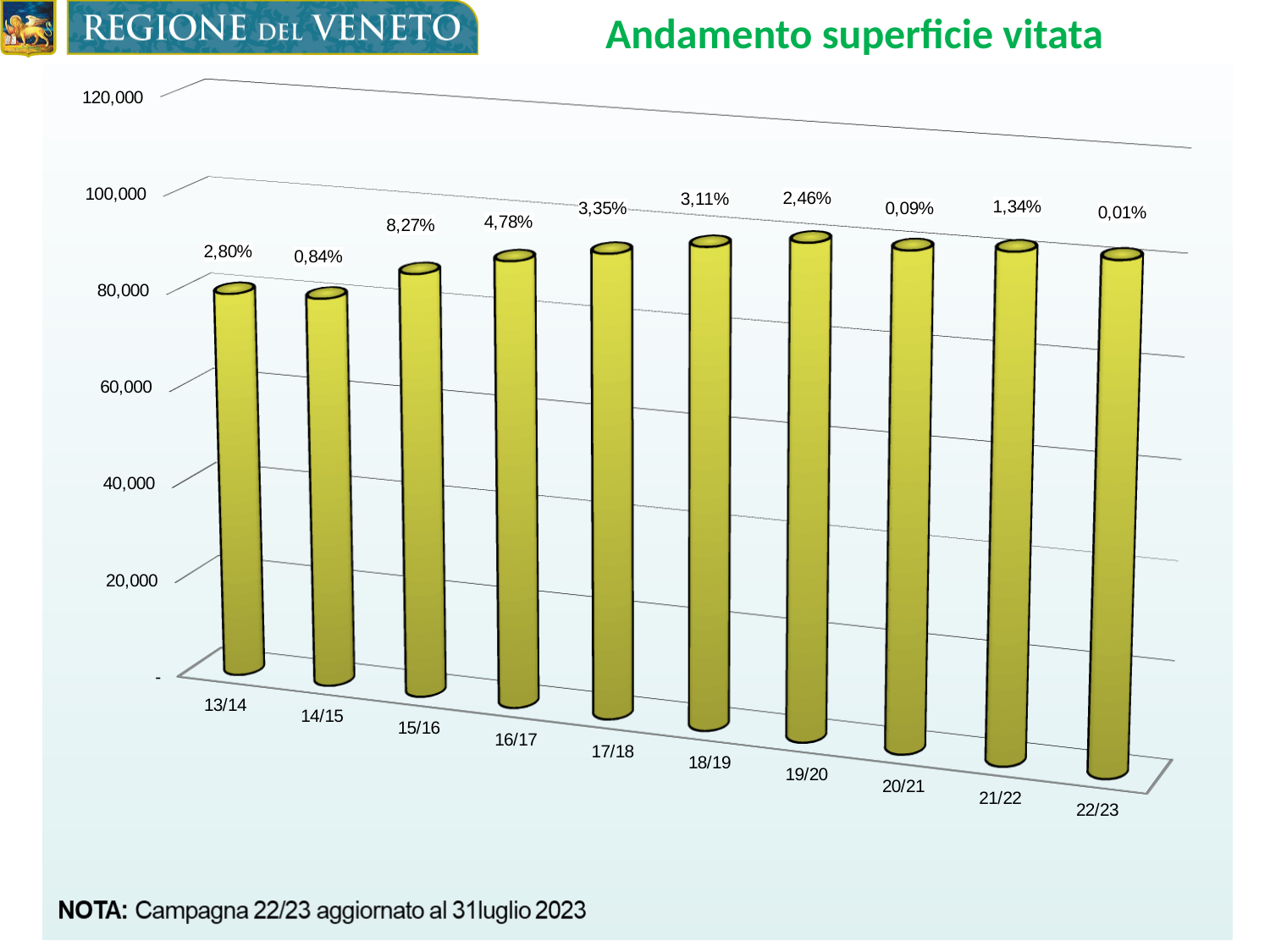
What is the title of the chart? Andamento superficie vitata Which campaign year has the highest percentage label printed above its bar? 15/16 What percentage label is printed above the bar for 22/23? 0,01% What percentage label is printed above the bar for 15/16? 8,27% Is the value of the bar for 13/14 greater or less than 100,000? less Which campaign year has the lowest percentage label printed above its bar? 22/23 How many campaign years (categories) are shown on the x axis? 10 What percentage label is printed above the bar for 20/21? 0,09% What is the difference between the percentage labels for 13/14 and 14/15? 1,96% Which has the larger percentage label, 16/17 or 17/18? 16/17 Is the value of the bar for 13/14 greater or less than 60,000? greater What kind of chart is shown on the slide? bar chart